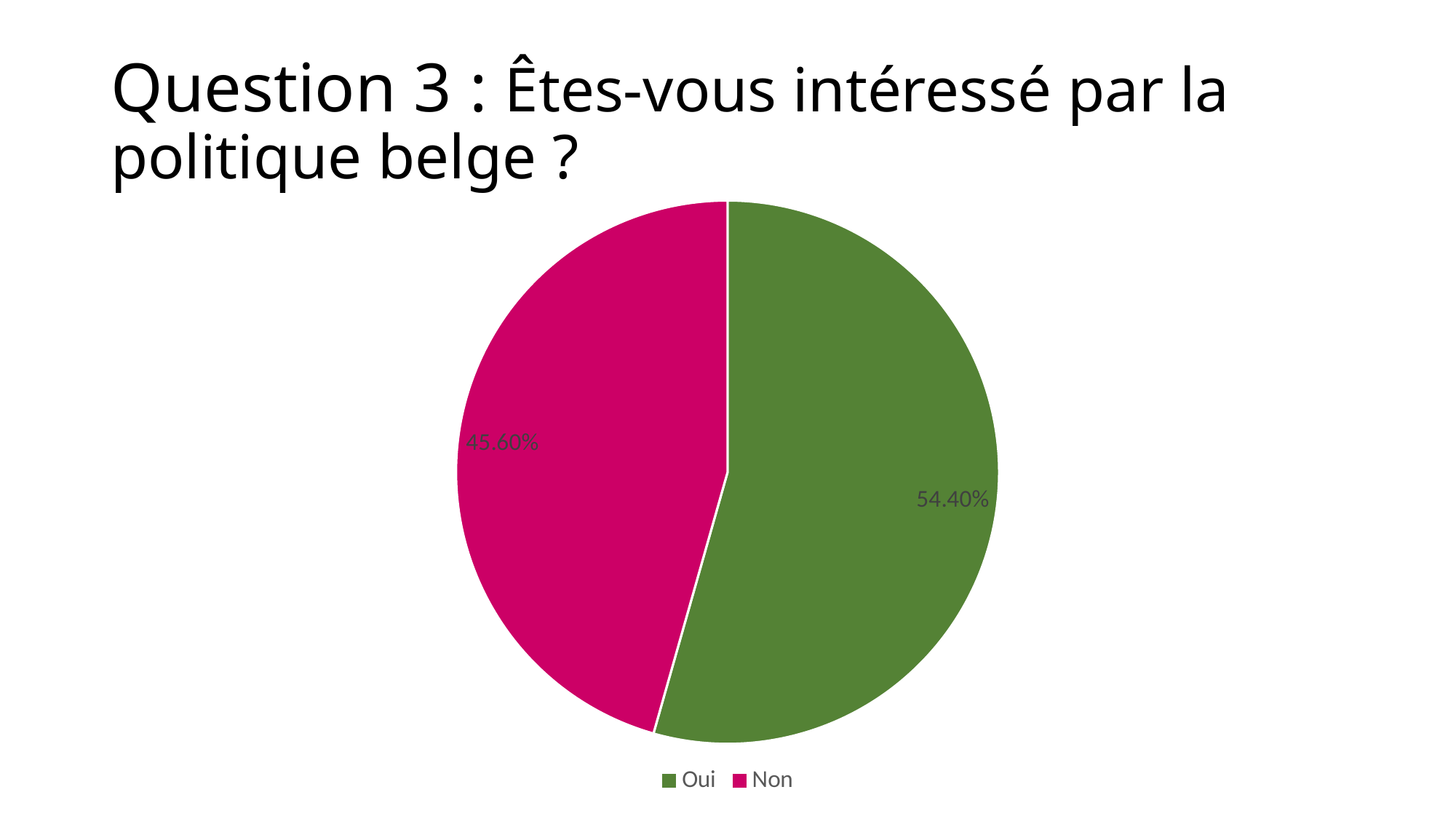
Which response has the largest share of the pie? Oui What is the difference in percentage points between the "Oui" and "Non" slices? 8.80% What share of the pie does the "Non" slice represent? 45.60% What percentage of respondents answered "Non"? 45.60% What kind of chart is shown on the slide? pie chart Which slice is larger, "Oui" or "Non"? Oui Which response has the smallest share of the pie? Non How many slices does the pie chart have? 2 How many entries does the legend list? 2 What colour is the "Non" slice? magenta What colour is the "Oui" slice? green What percentage of respondents answered "Oui"? 54.40%